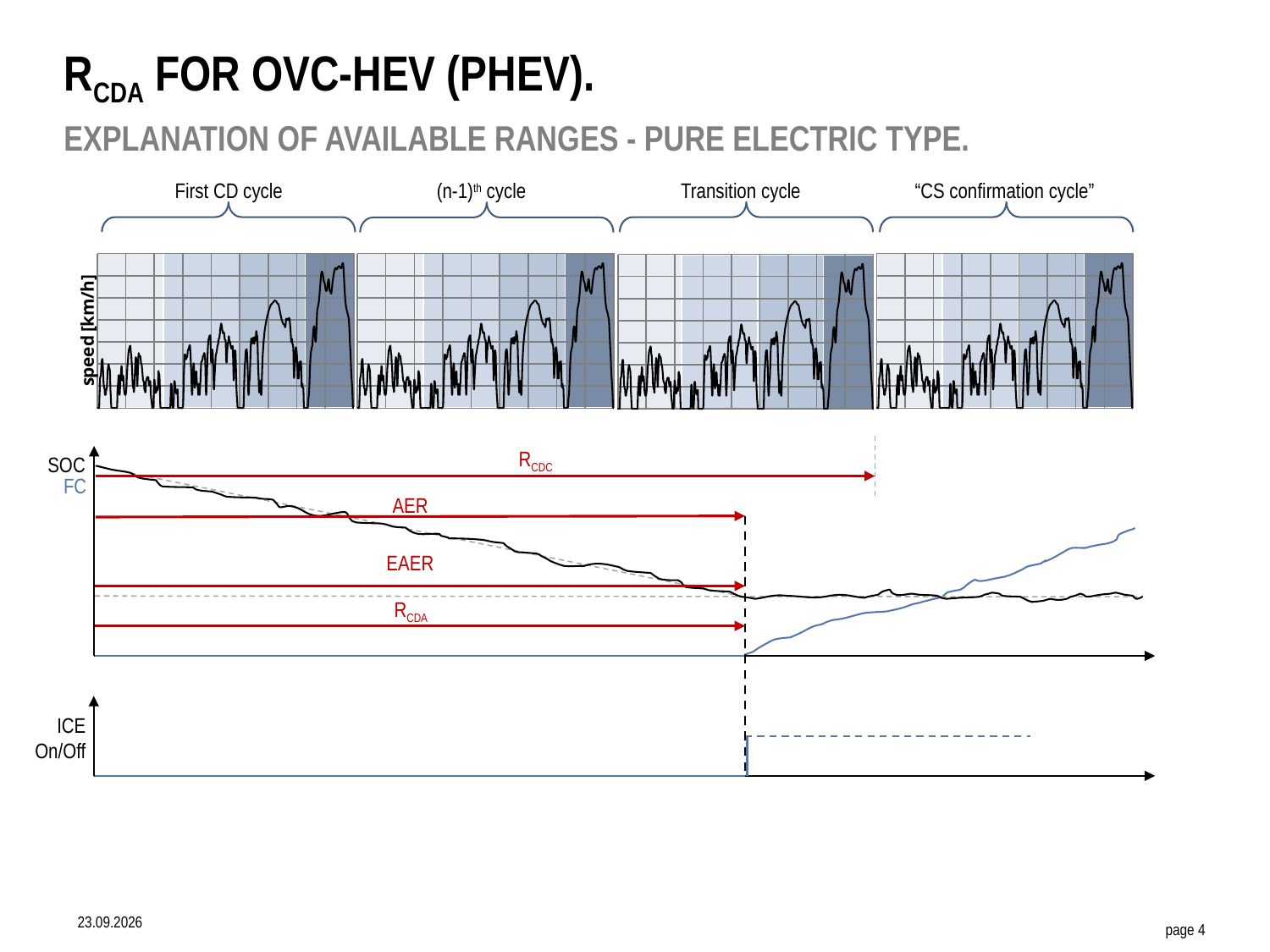
In the SOC/FC chart, does the SOC line rise or fall along the x axis during the CD cycles before the transition? fall What is the y-axis label of the speed profile charts in the top row? speed [km/h] In the SOC/FC chart, which range arrow is longer, R_CDC or AER? R_CDC How many red range arrows are drawn in the SOC/FC chart? 4 How many driving cycle segments are shown in the top speed row? 4 What kind of chart is used to show the speed profiles in the top row of the slide? line chart In the SOC/FC chart, is the FC line flat or rising during the first CD cycle? flat In the ICE On/Off chart, does the ICE switch on before or after the transition cycle begins? after In the SOC/FC chart, which of the labelled range arrows extends furthest along the x axis? R_CDC In the SOC/FC chart, does the blue FC line rise or fall along the x axis after the transition cycle? rise What is the label of the first cycle segment in the top row? First CD cycle